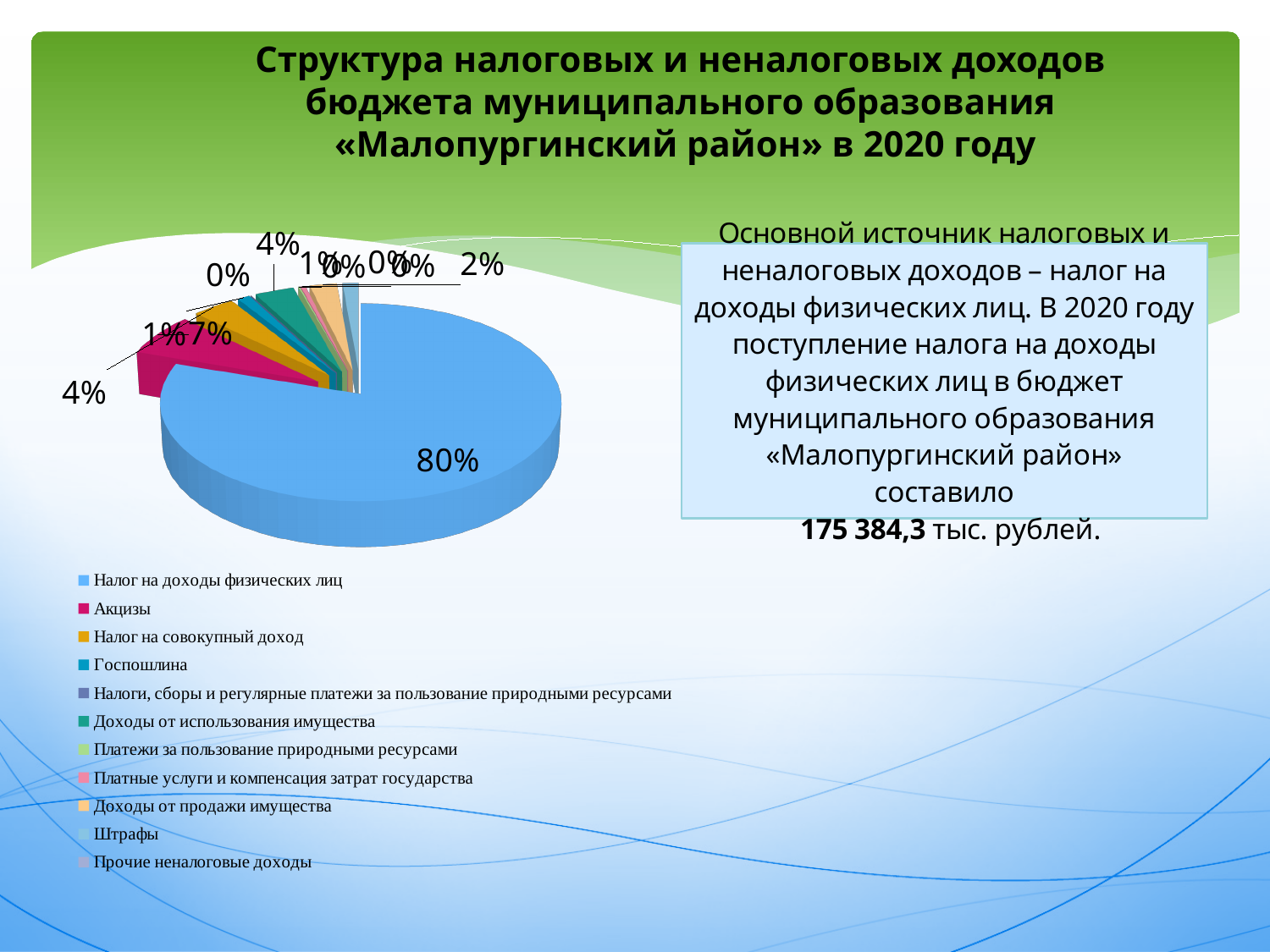
Which year does the chart title refer to? 2020 What colour is the slice for Налог на доходы физических лиц? light blue Which is larger: the share for Налог на совокупный доход or the share for Акцизы? Акцизы What kind of chart is shown on the slide? pie chart What share of the pie does Акцизы have? 7% What is the difference in percentage points between the share for Налог на доходы физических лиц and the share for Налог на совокупный доход? 76 How many categories does the legend list? 11 What share of the pie does Налог на доходы физических лиц have? 80% Which category has the largest share of the pie? Налог на доходы физических лиц What share of the pie does Налог на совокупный доход have? 4% Which is larger: the share for Налог на доходы физических лиц or the share for Акцизы? Налог на доходы физических лиц